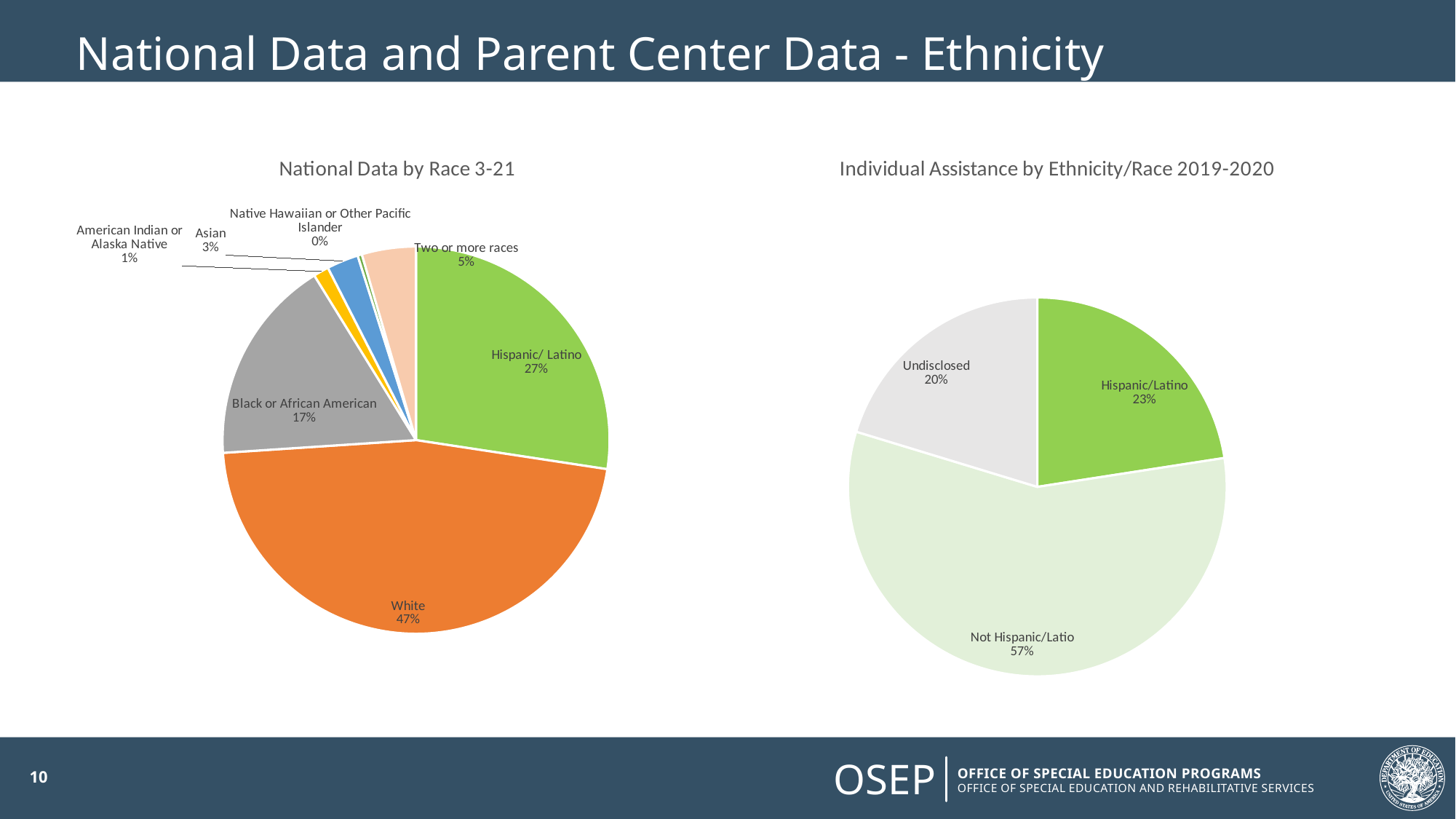
In the 'Individual Assistance by Ethnicity/Race 2019-2020' chart, what percentage is shown for Not Hispanic/Latio? 57% In the 'National Data by Race 3-21' chart, what percentage is shown for Hispanic/ Latino? 27% In the 'Individual Assistance by Ethnicity/Race 2019-2020' chart, what percentage is shown for Undisclosed? 20% In the 'National Data by Race 3-21' chart, what percentage is shown for Black or African American? 17% In the 'National Data by Race 3-21' chart, which category has the smallest share? Native Hawaiian or Other Pacific Islander In the 'Individual Assistance by Ethnicity/Race 2019-2020' chart, which is larger, Hispanic/Latino or Undisclosed? Hispanic/Latino In the 'National Data by Race 3-21' chart, what percentage is shown for White? 47% In the 'Individual Assistance by Ethnicity/Race 2019-2020' chart, how many categories are shown? 3 In the 'National Data by Race 3-21' chart, how many categories are shown? 7 In the 'National Data by Race 3-21' chart, which category has the largest share? White What type of chart is the 'Individual Assistance by Ethnicity/Race 2019-2020' chart? Pie chart In the 'National Data by Race 3-21' chart, what is the difference between the White and Hispanic/ Latino shares? 20%